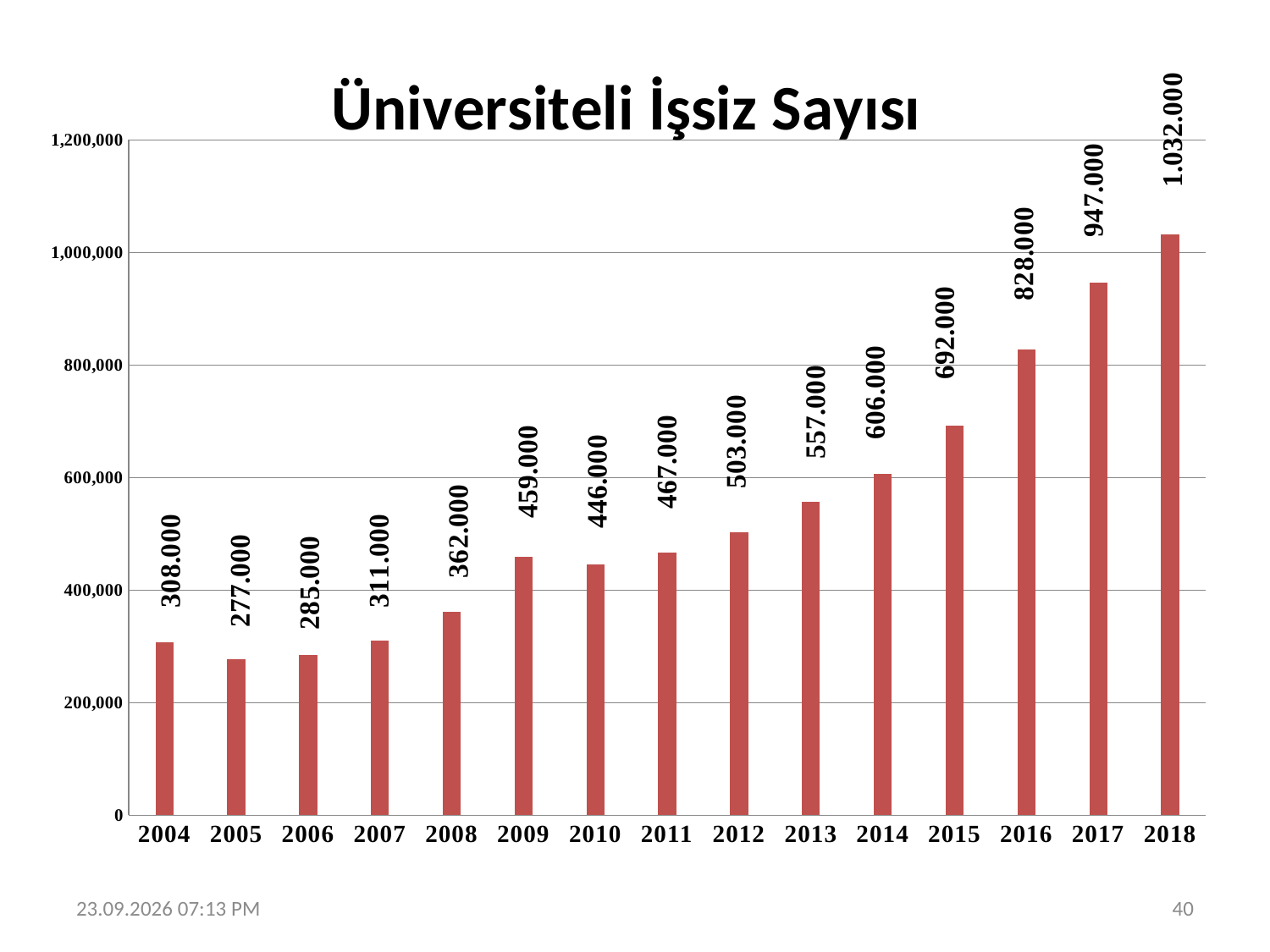
How many years are shown on the x axis? 15 Is the value for 2015 greater or less than 600,000? greater What is the value for 2004? 308.000 What is the value for 2018? 1.032.000 What is the title of the chart? Üniversiteli İşsiz Sayısı What is the value for 2010? 446.000 Which is larger, the value for 2009 or the value for 2010? 2009 What is the difference between the values for 2018 and 2017? 85.000 What is the difference between the values for 2009 and 2008? 97.000 What kind of chart is this? bar chart Which year has the highest value? 2018 Which year has the lowest value? 2005